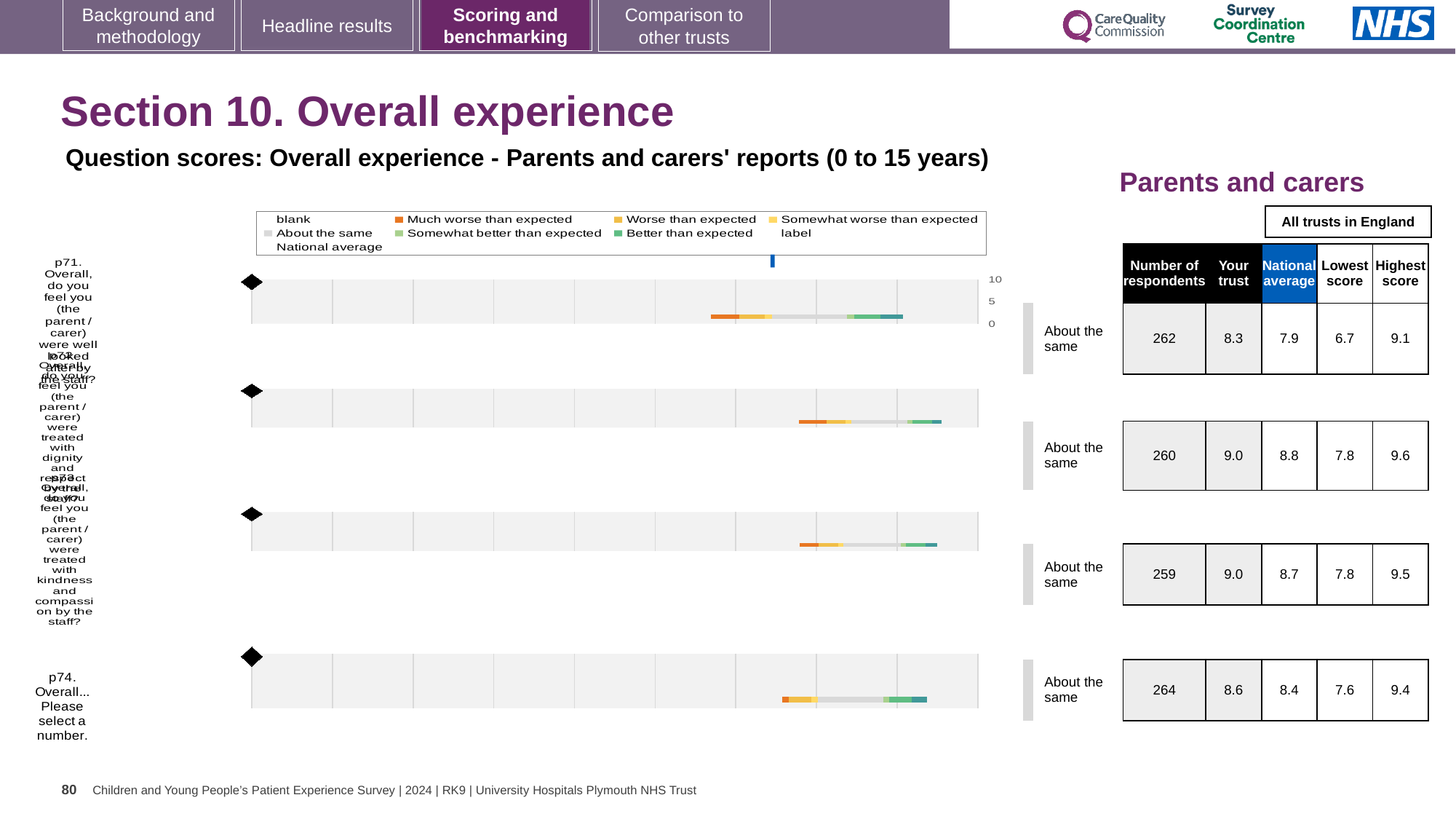
How many respondents answered the first (top) question, p71? 262 What is the 'Your trust' score for p74 (Overall... Please select a number)? 8.6 For the first (top) question, p71, which is larger: the 'Your trust' score or the national average? Your trust What is the lowest score among all trusts in England for the first (top) question, p71? 6.7 What is the difference between the 'Your trust' score and the national average for p74? 0.2 How many questions (bars) are plotted in the chart? 4 Which question has the lowest 'Your trust' score? p71 (the top question) How many entries does the chart legend list? 9 What kind of chart is used to show the question scores on this slide? bar chart What benchmark category is shown for the fourth (bottom) question, p74? About the same What is the highest score among all trusts in England for p74? 9.4 What is the national average score for p74 (Overall... Please select a number)? 8.4